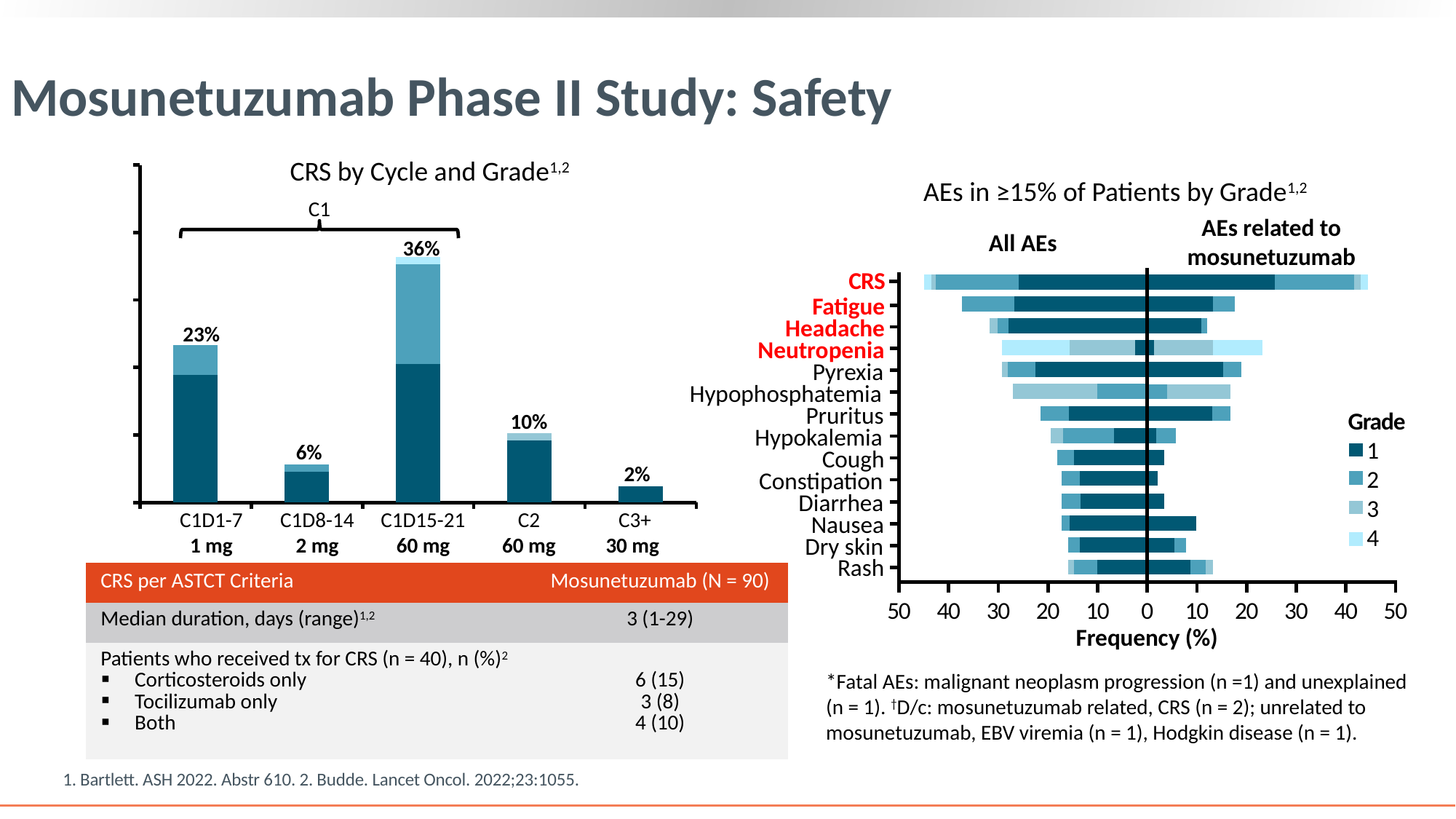
In the 'AEs in ≥15% of Patients by Grade' chart, how many grades does the legend list? 4 In the 'CRS by Cycle and Grade' chart, what is the CRS rate for C1D8-14? 6% How many cycle periods are shown in the 'CRS by Cycle and Grade' chart? 5 What type of chart is 'CRS by Cycle and Grade'? Bar chart In the 'CRS by Cycle and Grade' chart, which cycle period has the highest CRS rate? C1D15-21 In the 'AEs in ≥15% of Patients by Grade' chart, is the All AEs frequency for CRS greater or less than 40? greater In the 'CRS by Cycle and Grade' chart, what is the difference between the CRS rates for C1D15-21 and C1D1-7? 13% How many adverse events are listed in the 'AEs in ≥15% of Patients by Grade' chart? 14 In the 'AEs in ≥15% of Patients by Grade' chart, is the All AEs frequency for Rash greater or less than 20? less In the 'CRS by Cycle and Grade' chart, which cycle period has the lowest CRS rate? C3+ In the 'CRS by Cycle and Grade' chart, which has a higher CRS rate, C2 or C1D8-14? C2 In the 'CRS by Cycle and Grade' chart, what is the total CRS rate for C1D15-21? 36%